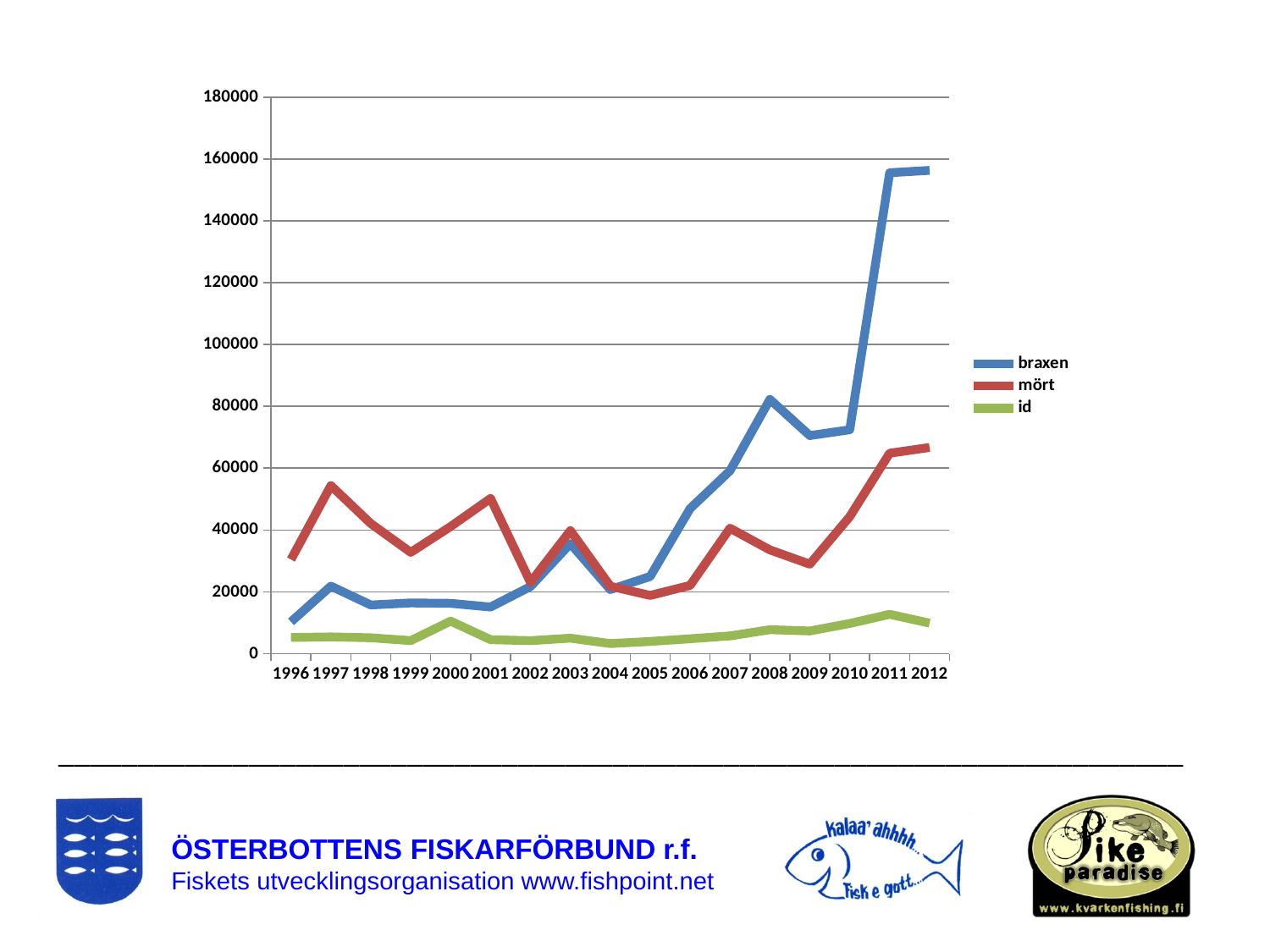
How many series does the legend list? 3 How many years are shown on the x axis? 17 Which series has the lowest value in 2012? id Is the value for mört in 1997 greater or less than 40000? greater In 1997, which is larger, the value for braxen or the value for mört? mört Which series has the highest value in 2012? braxen Is the value for id in 2011 greater or less than 20000? less Is the value for braxen in 2012 greater or less than 140000? greater Does the braxen series overall rise or fall from 1996 to 2012? rise What colour is the line for braxen? blue What kind of chart is shown on the slide? line chart